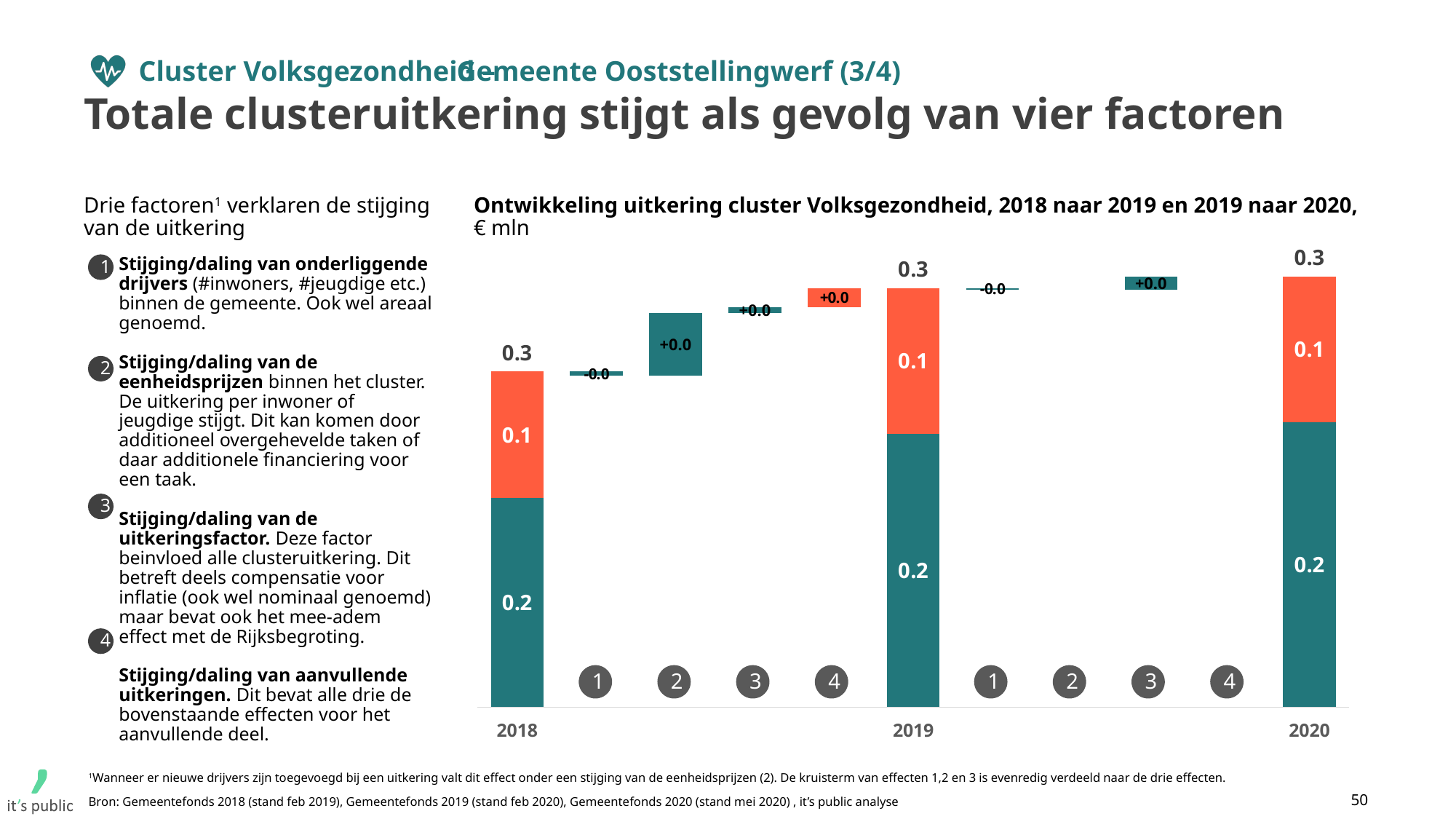
What is the value labelled for effect 1 between 2018 and 2019? -0.0 What is the difference between the total of the 2020 bar and the total of the 2018 bar? 0.0 Which segment of the 2019 bar is larger, the teal segment or the orange segment? the teal segment What is the value of the teal (lower) segment of the 2018 bar? 0.2 In what unit are the values in the chart expressed? € mln What is the title of the chart? Ontwikkeling uitkering cluster Volksgezondheid, 2018 naar 2019 en 2019 naar 2020, € mln What is the total value of the 2020 bar? 0.3 What is the total value of the 2018 bar? 0.3 What is the value of the orange (upper) segment of the 2020 bar? 0.1 What is the value labelled for effect 2 between 2018 and 2019? +0.0 What kind of chart is shown on the slide? bar chart (waterfall) How many year labels are shown on the x axis? 3